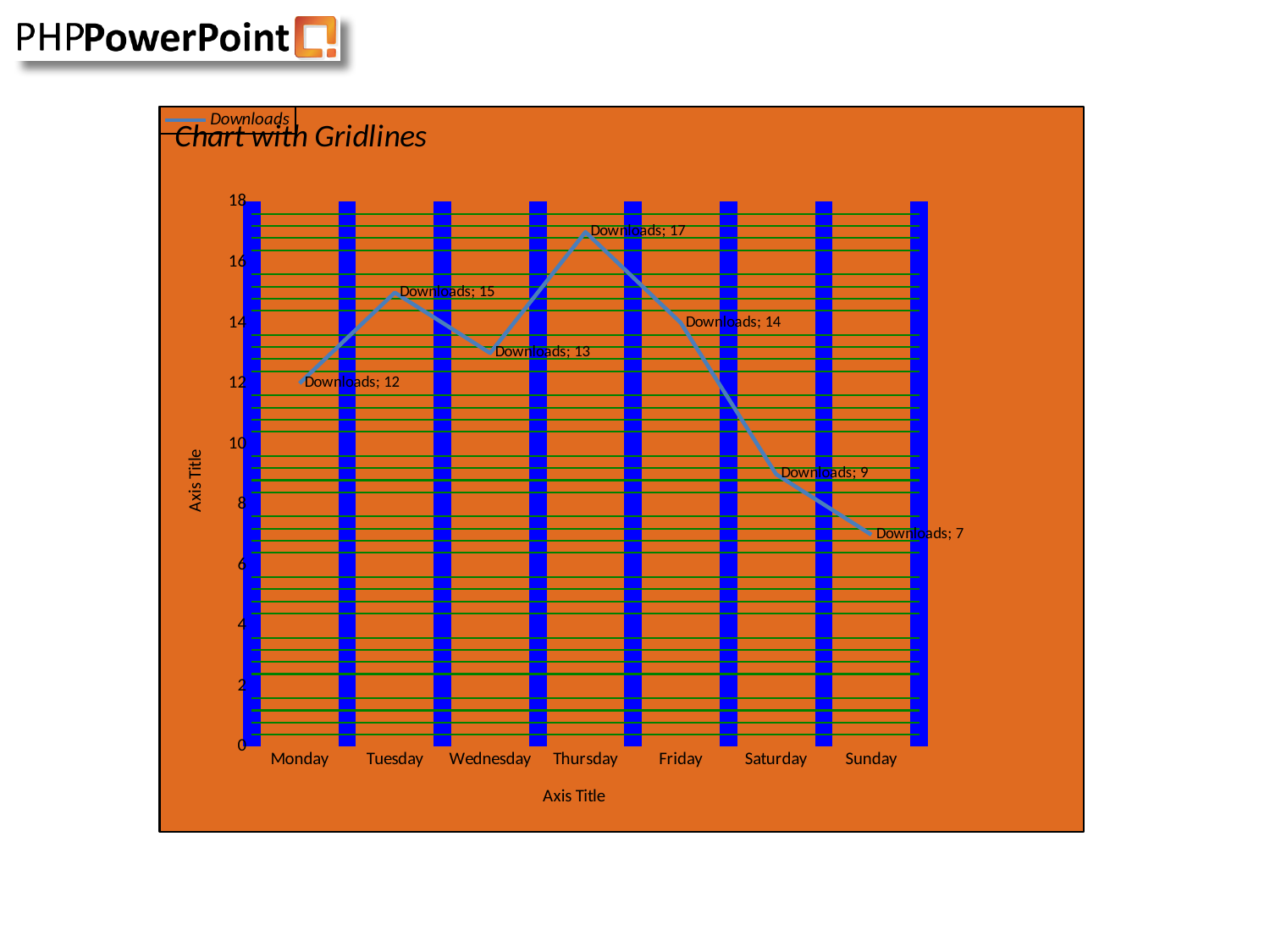
How many days are plotted on the x axis? 7 How many series does the legend list? 1 What is the title of the chart? Chart with Gridlines What is the Downloads value for Thursday? 17 Which has a larger Downloads value, Tuesday or Wednesday? Tuesday What is the difference between the Downloads values for Thursday and Sunday? 10 What is the Downloads value for Sunday? 7 Which day has the lowest Downloads value? Sunday Is the Downloads value for Saturday greater or less than 10? less What kind of chart is shown? line chart What is the Downloads value for Monday? 12 Which day has the highest Downloads value? Thursday